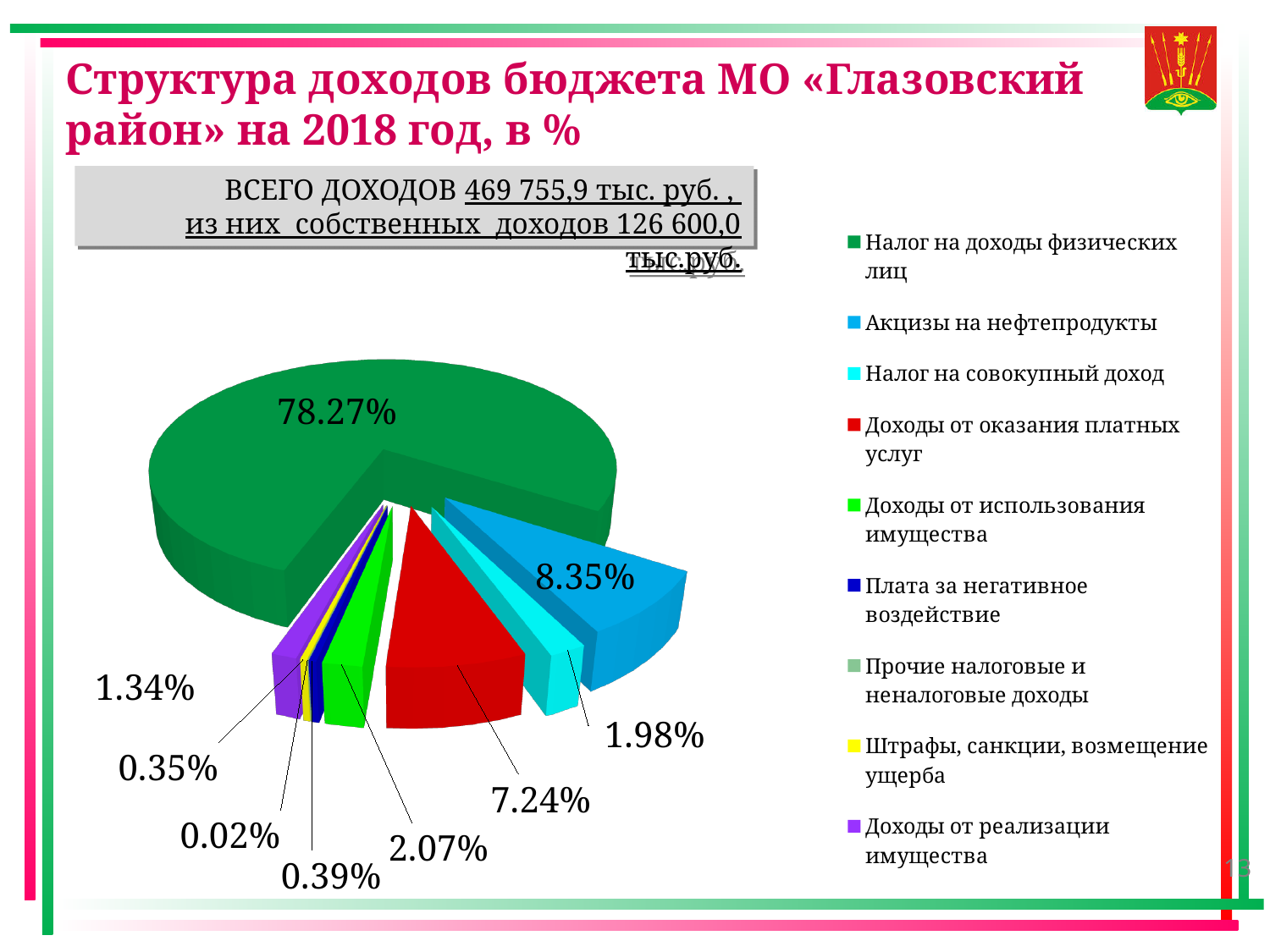
What share of budget revenue does «Налог на доходы физических лиц» account for? 78.27% What share is shown for «Доходы от использования имущества»? 2.07% How many revenue categories does the legend list? 9 What share is shown for «Налог на совокупный доход»? 1.98% What share is shown for «Доходы от оказания платных услуг»? 7.24% Which has the larger share: «Акцизы на нефтепродукты» or «Доходы от оказания платных услуг»? Акцизы на нефтепродукты What kind of chart is shown on the slide? pie chart By how many percentage points does the share of «Налог на доходы физических лиц» exceed that of «Акцизы на нефтепродукты»? 69.92% What share is shown for «Акцизы на нефтепродукты»? 8.35% What is the smallest percentage labelled on the pie chart? 0.02% What colour is the slice for «Доходы от оказания платных услуг»? red Which revenue category has the largest share of the pie? Налог на доходы физических лиц